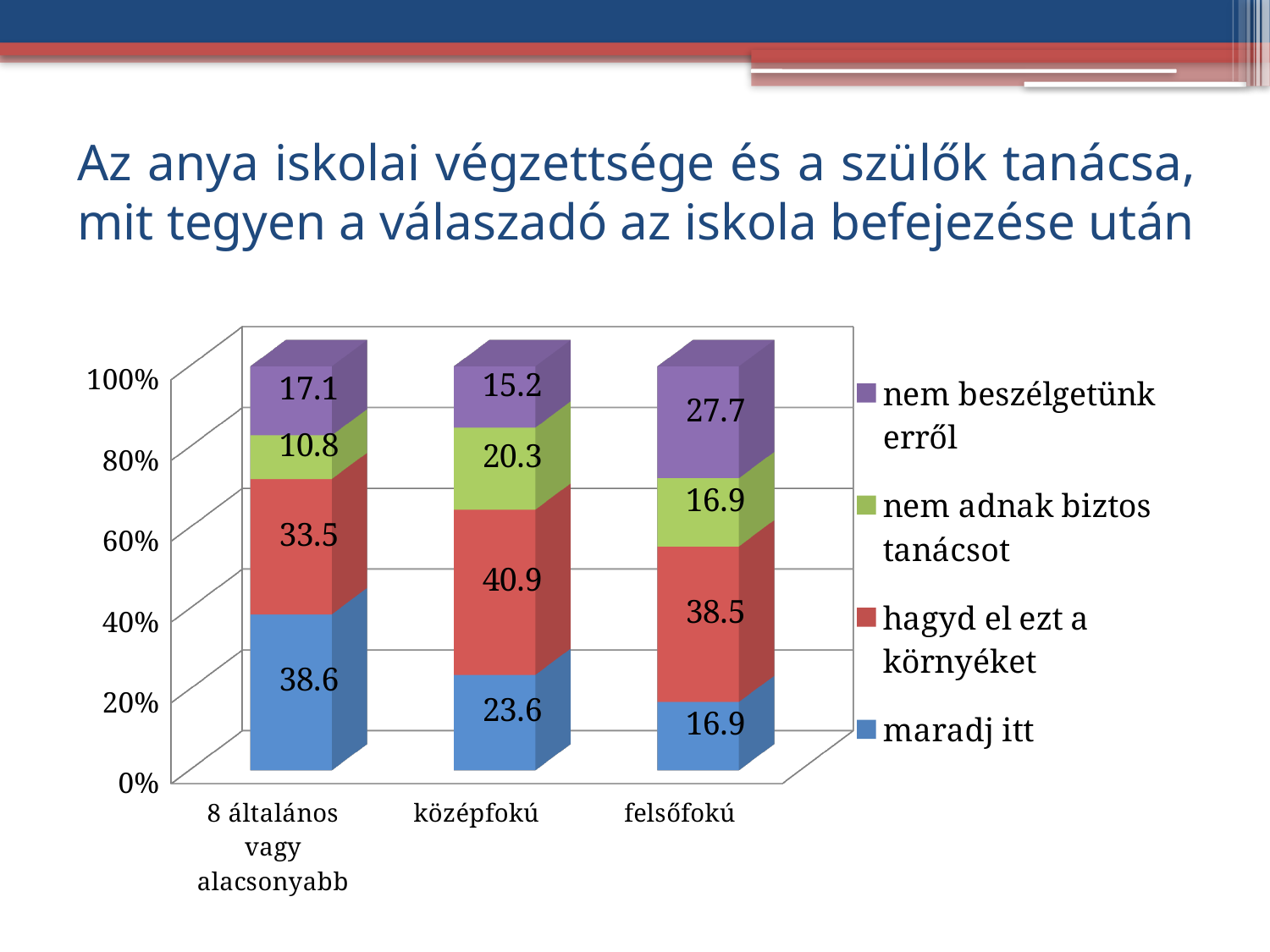
What is the value for "nem beszélgetünk erről" in the "felsőfokú" category? 27.7 What is the value for "hagyd el ezt a környéket" in the "középfokú" category? 40.9 What kind of chart is shown on the slide? stacked bar chart What is the value for "nem adnak biztos tanácsot" in the "középfokú" category? 20.3 Which category has the larger value for "hagyd el ezt a környéket": "középfokú" or "felsőfokú"? középfokú Which category has the lowest value for "nem beszélgetünk erről"? középfokú Which category has the highest value for "maradj itt"? 8 általános vagy alacsonyabb What is the value for "maradj itt" in the "8 általános vagy alacsonyabb" category? 38.6 Do the values for "maradj itt" rise or fall from left to right along the x axis? fall How many categories are shown on the x axis? 3 How many series does the legend list? 4 What is the difference between the "maradj itt" values for "8 általános vagy alacsonyabb" and "középfokú"? 15